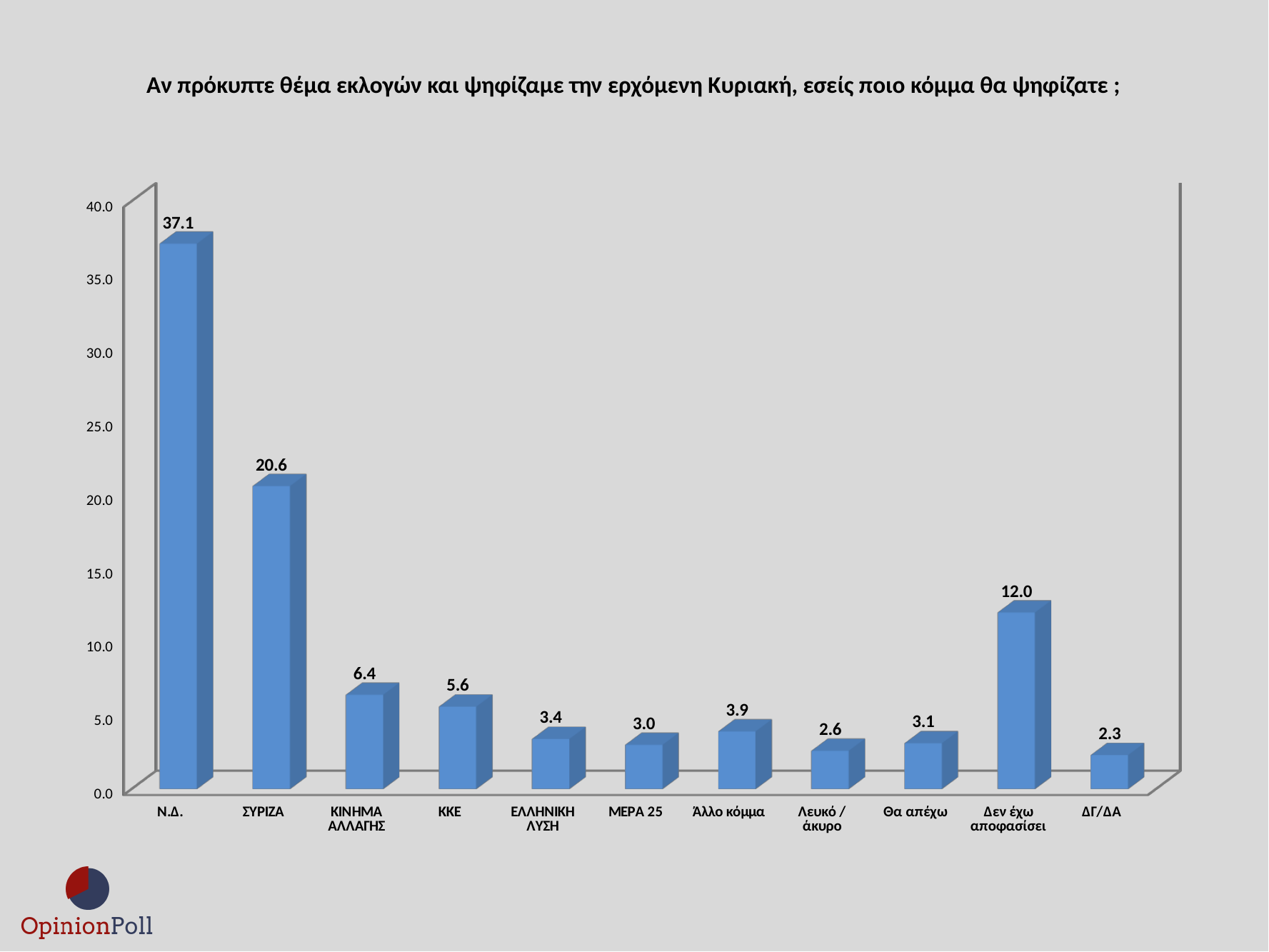
What is the difference between the values for Ν.Δ. and ΣΥΡΙΖΑ? 16.5 Is the value for ΣΥΡΙΖΑ greater or less than 25.0? less What is the value for Δεν έχω αποφασίσει? 12.0 What kind of chart is shown on the slide? bar chart Which is larger, the value for ΚΙΝΗΜΑ ΑΛΛΑΓΗΣ or the value for ΚΚΕ? ΚΙΝΗΜΑ ΑΛΛΑΓΗΣ What is the value for Ν.Δ.? 37.1 Which category has the highest value? Ν.Δ. What is the value for ΣΥΡΙΖΑ? 20.6 How many categories are shown on the x axis? 11 What is the value for ΚΚΕ? 5.6 What is the difference between the values for Άλλο κόμμα and Λευκό / άκυρο? 1.3 Which category has the lowest value? ΔΓ/ΔΑ